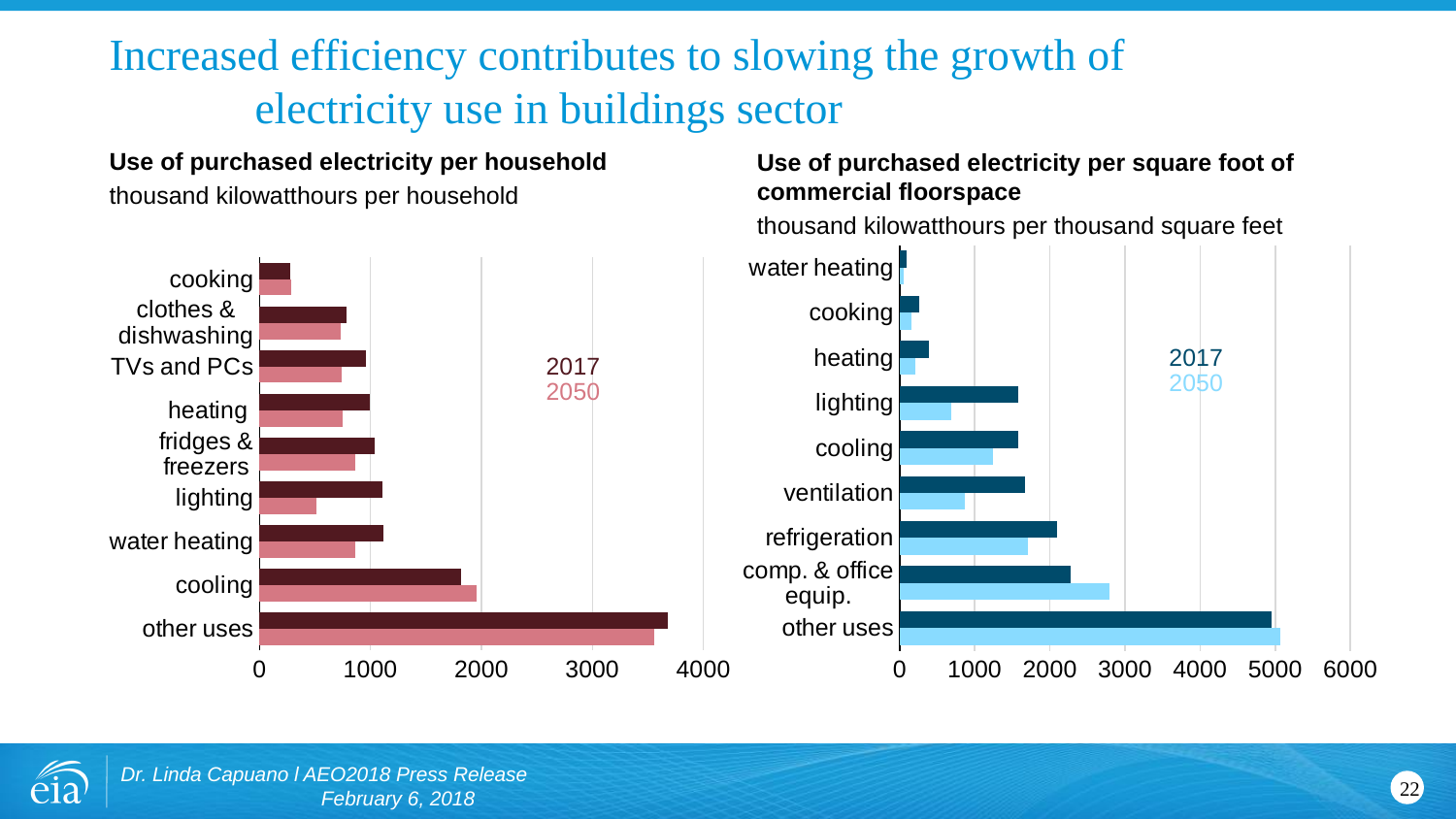
What kind of chart is the 'Use of purchased electricity per household' chart? bar chart How many series does the legend list in the 'Use of purchased electricity per square foot of commercial floorspace' chart? 2 In the 'Use of purchased electricity per household' chart, is the 2050 value for lighting greater or less than 1000? less In the 'Use of purchased electricity per household' chart, which category has the highest 2017 value? other uses What unit is given in the subtitle of the 'Use of purchased electricity per square foot of commercial floorspace' chart? thousand kilowatthours per thousand square feet In the 'Use of purchased electricity per household' chart, is the 2017 value for other uses greater or less than 3000? greater In the 'Use of purchased electricity per household' chart, which is larger for lighting, the 2017 value or the 2050 value? 2017 How many categories are shown in the 'Use of purchased electricity per household' chart? 9 In the 'Use of purchased electricity per household' chart, which category has the lowest 2017 value? cooking In the 'Use of purchased electricity per square foot of commercial floorspace' chart, which category has the lowest 2017 value? water heating In the 'Use of purchased electricity per square foot of commercial floorspace' chart, which is larger for comp. & office equip., the 2017 value or the 2050 value? 2050